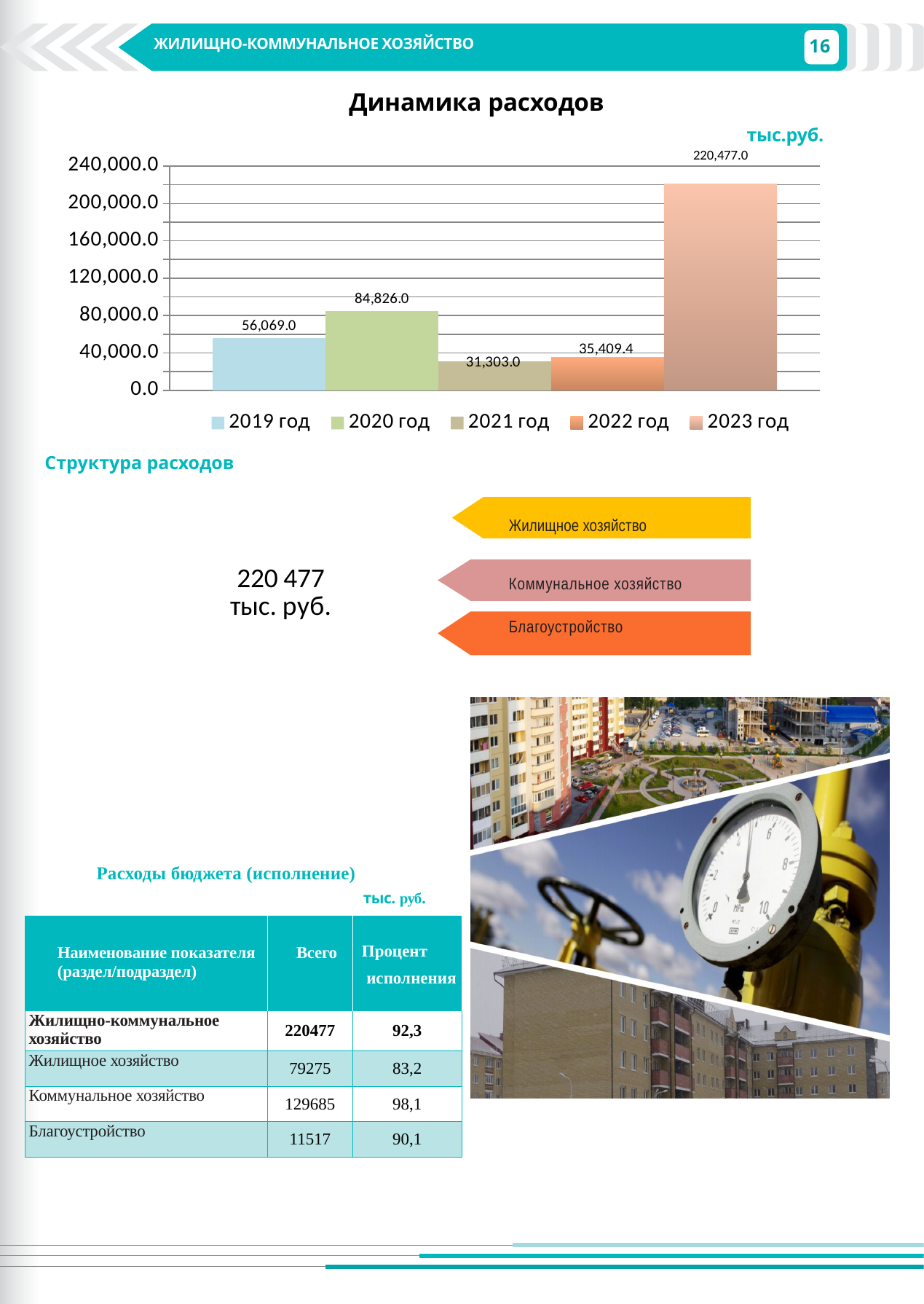
What is the value for 2021 год in the Динамика расходов chart? 31,303.0 Which year has the highest value in the Динамика расходов chart? 2023 год How many entries does the legend of the Динамика расходов chart list? 5 What is the value for 2023 год in the Динамика расходов chart? 220,477.0 How many bars are plotted in the Динамика расходов chart? 5 Which year has the lowest value in the Динамика расходов chart? 2021 год What is the value for 2022 год in the Динамика расходов chart? 35,409.4 What is the value for 2020 год in the Динамика расходов chart? 84,826.0 Which is larger in the Динамика расходов chart, the value for 2022 год or 2021 год? 2022 год What type of chart is Динамика расходов? bar chart What is the difference between the values for 2020 год and 2019 год in the Динамика расходов chart? 28,757.0 What is the value for 2019 год in the Динамика расходов chart? 56,069.0